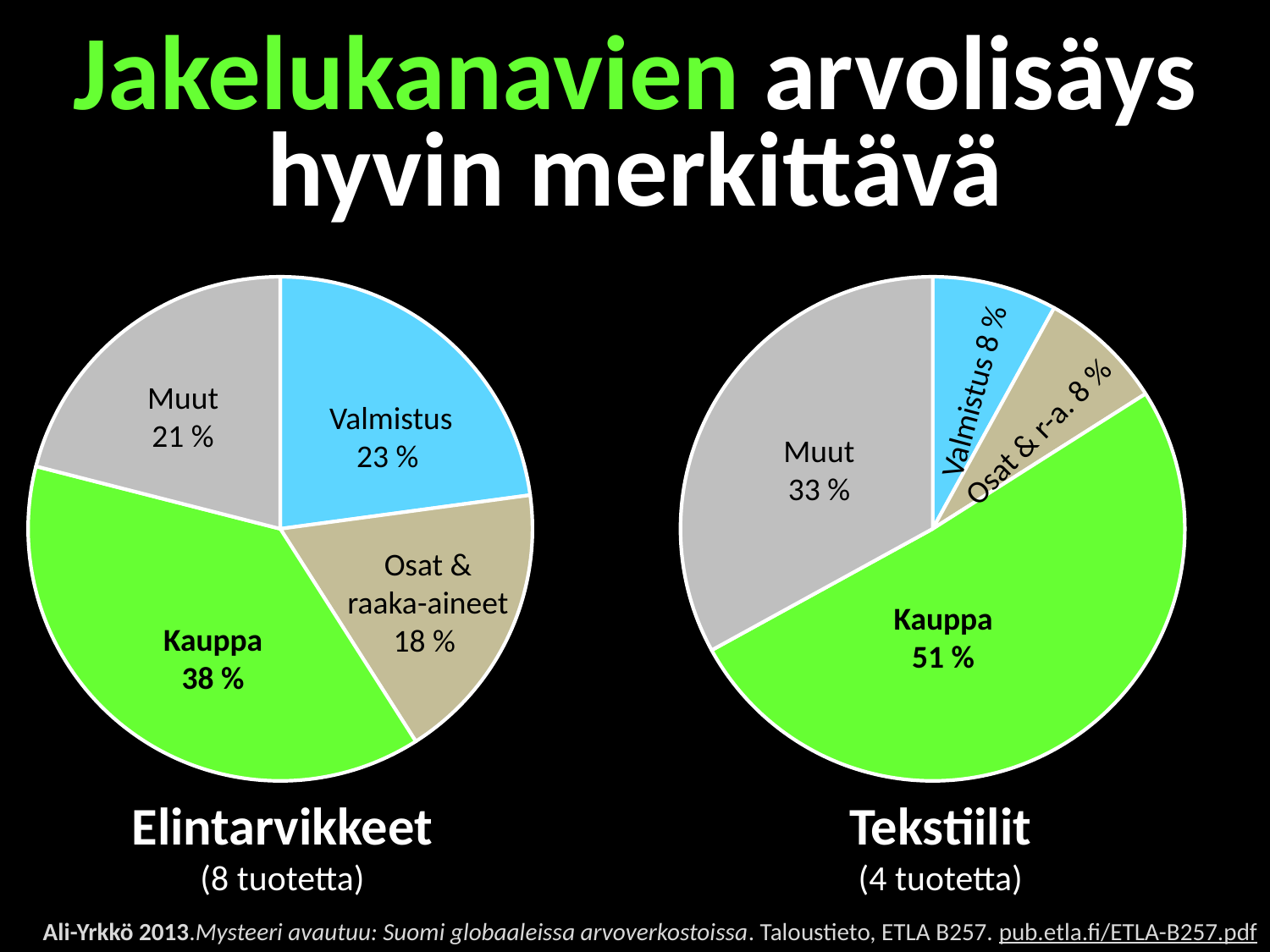
What type of chart is used for Elintarvikkeet? Pie chart What is the difference between the Kauppa share in the Tekstiilit chart and the Kauppa share in the Elintarvikkeet chart? 13 % In the Tekstiilit pie chart, what share does Valmistus have? 8 % In the Tekstiilit pie chart, what share does Muut have? 33 % How many products does the Tekstiilit chart cover, according to its subtitle? 4 tuotetta In the Elintarvikkeet pie chart, which slice is the smallest? Osat & raaka-aineet In the Elintarvikkeet pie chart, which slice is the largest? Kauppa In the Elintarvikkeet pie chart, what share does Osat & raaka-aineet have? 18 % How many slices does the Tekstiilit pie chart have? 4 In the Tekstiilit pie chart, which slice is the largest? Kauppa In the Elintarvikkeet pie chart, which is larger, Valmistus or Muut? Valmistus In the Elintarvikkeet pie chart, what share does Kauppa have? 38 %